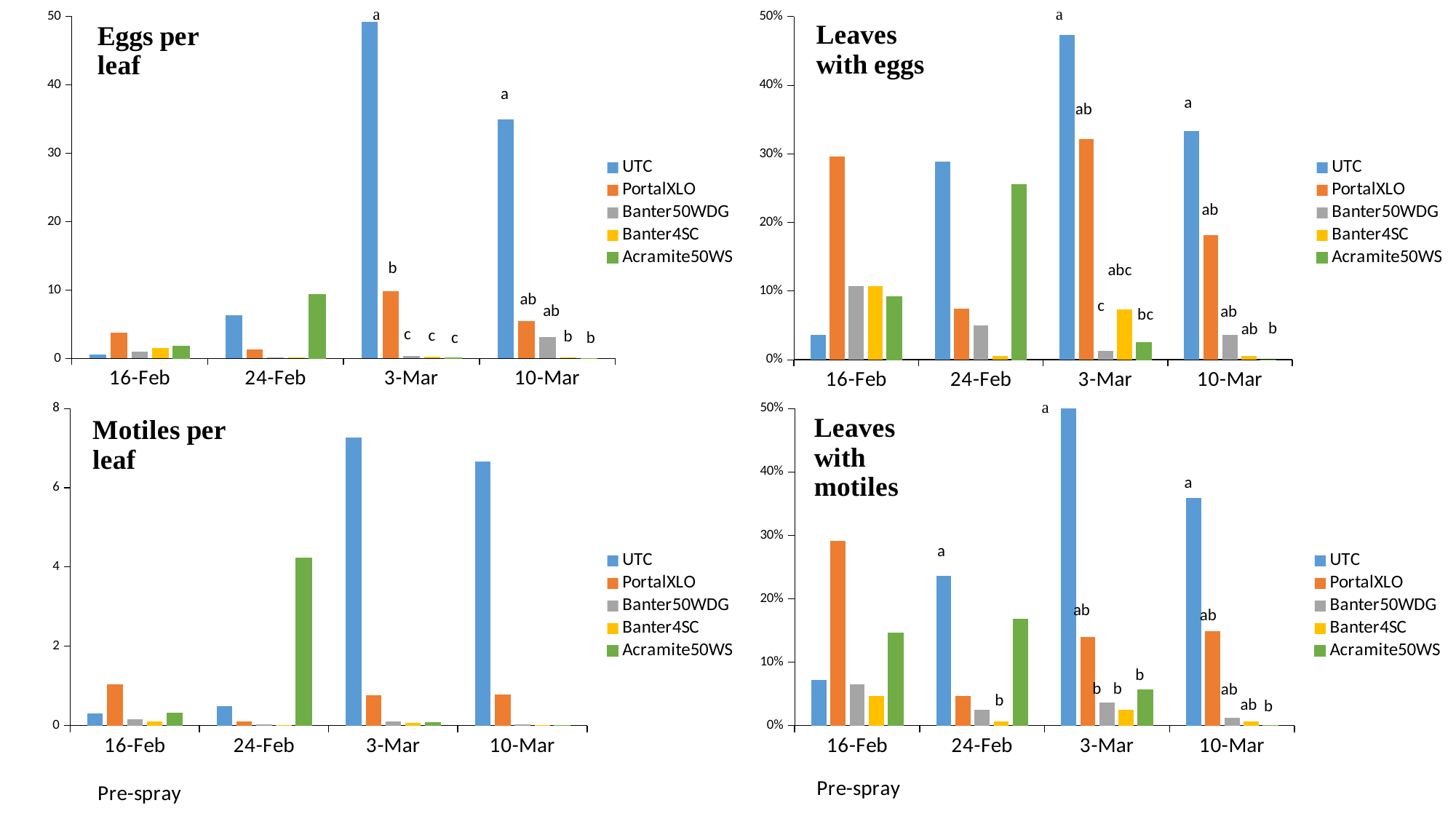
In the "Motiles per leaf" chart, is the UTC value on 3-Mar greater or less than 6? greater Which series is shown in green in the legend of the "Eggs per leaf" chart? Acramite50WS In the "Eggs per leaf" chart, is the UTC value on 3-Mar greater or less than 40? greater In the "Leaves with eggs" chart, on 16-Feb, which is larger: PortalXLO or UTC? PortalXLO In the "Eggs per leaf" chart, on which date is the UTC bar highest? 3-Mar How many dates are shown on the x axis of the "Motiles per leaf" chart? 4 What kind of chart is the "Eggs per leaf" chart? bar chart In the "Motiles per leaf" chart, on 24-Feb, which is larger: Acramite50WS or UTC? Acramite50WS How many series does the legend of the "Leaves with eggs" chart list? 5 In the "Leaves with eggs" chart, is the UTC value on 3-Mar greater or less than 40%? greater In the "Leaves with motiles" chart, which series has the highest value on 16-Feb? PortalXLO